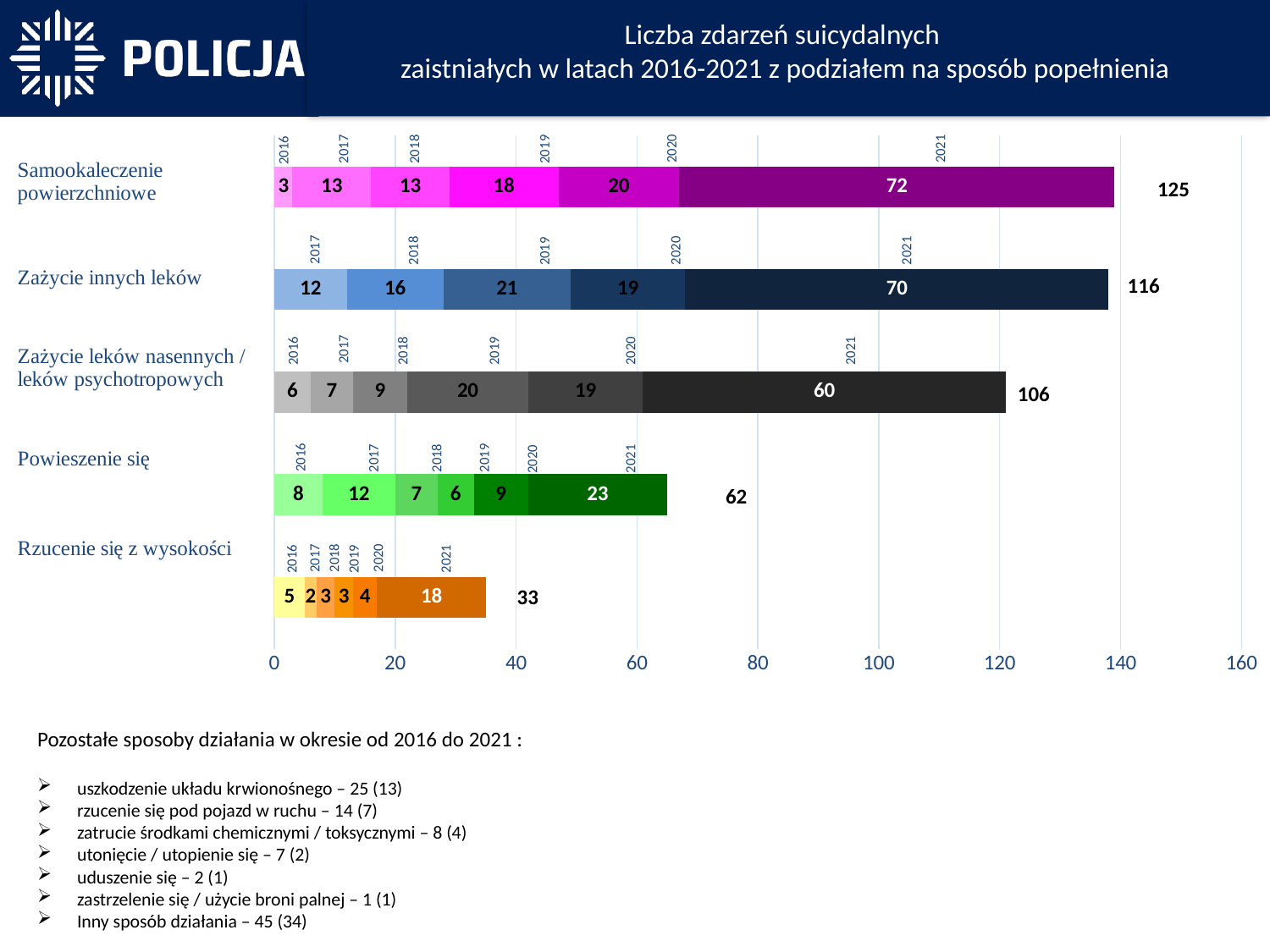
How many categories (methods) are shown on the chart? 5 Which category has the longest stacked bar? Samookaleczenie powierzchniowe What is the value for 2019 in the 'Zażycie innych leków' bar? 21 Which is larger: the 2020 value for 'Samookaleczenie powierzchniowe' or the 2020 value for 'Powieszenie się'? Samookaleczenie powierzchniowe What kind of chart is shown on the slide? Stacked bar chart What is the value for 2016 in the 'Rzucenie się z wysokości' bar? 5 Which category has the shortest stacked bar? Rzucenie się z wysokości What range of years does the chart title say the data covers? 2016-2021 What is the value for 2021 in the 'Powieszenie się' bar? 23 What is the difference between the 2021 value for 'Zażycie innych leków' and the 2021 value for 'Zażycie leków nasennych / leków psychotropowych'? 10 What is the value for 2021 in the 'Samookaleczenie powierzchniowe' bar? 72 What is the value for 2018 in the 'Zażycie leków nasennych / leków psychotropowych' bar? 9